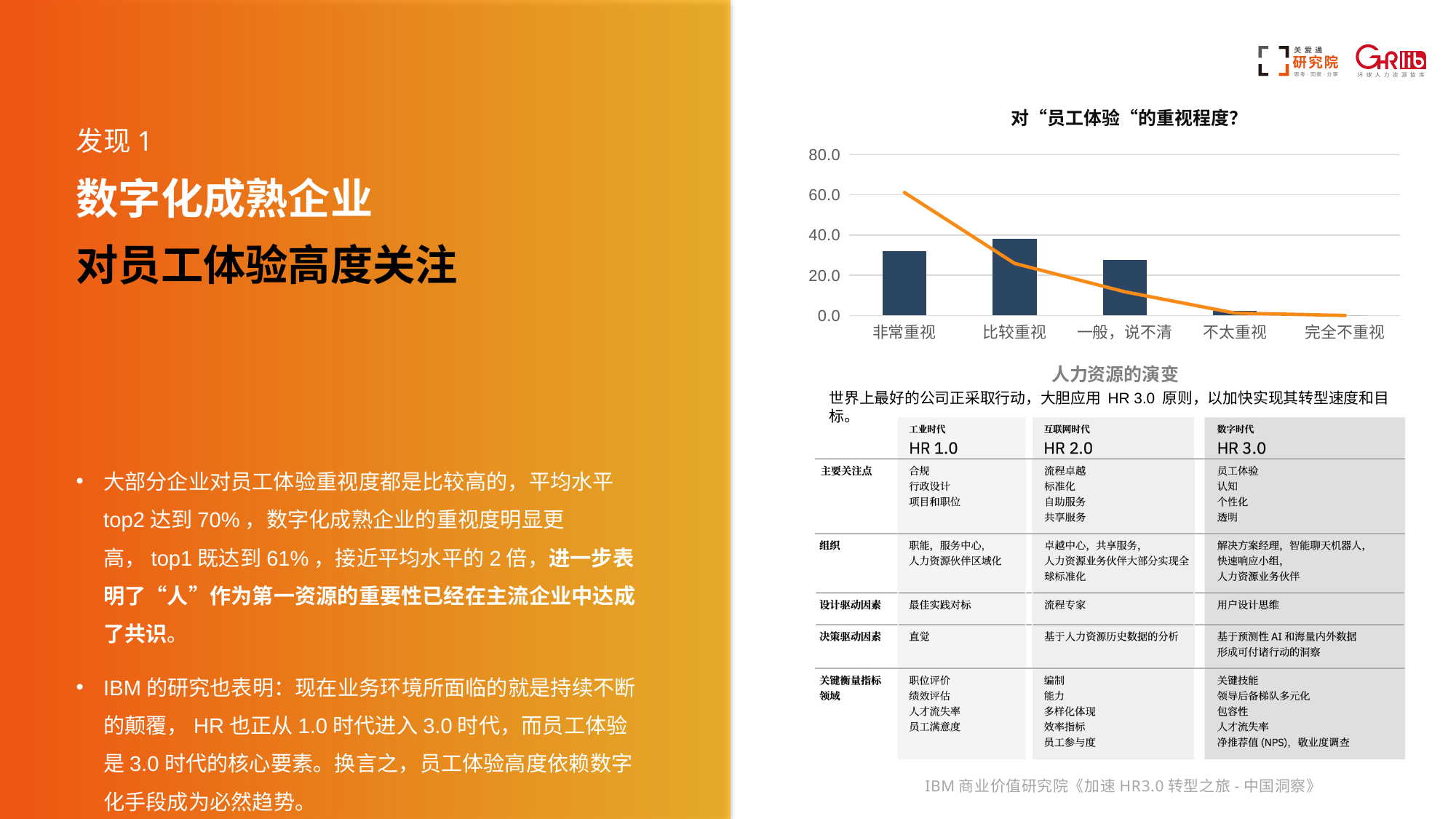
In the 对“员工体验“的重视程度? chart, is the bar for 非常重视 greater or less than 20.0? greater In the 对“员工体验“的重视程度? chart, does the orange line rise or fall from 非常重视 to 完全不重视? It falls In the 对“员工体验“的重视程度? chart, is the bar for 不太重视 greater or less than 20.0? less In the 对“员工体验“的重视程度? chart, is the line value at 非常重视 greater or less than 40.0? greater Which category has the lowest bar in the 对“员工体验“的重视程度? chart? 完全不重视 What is the highest value shown on the y axis of the 对“员工体验“的重视程度? chart? 80.0 Which category has the tallest bar in the 对“员工体验“的重视程度? chart? 比较重视 In the 对“员工体验“的重视程度? chart, which bar is taller: 比较重视 or 不太重视? 比较重视 What kind of chart is shown under the title 对“员工体验“的重视程度? A bar chart combined with a line How many categories are shown on the x axis of the 对“员工体验“的重视程度? chart? 5